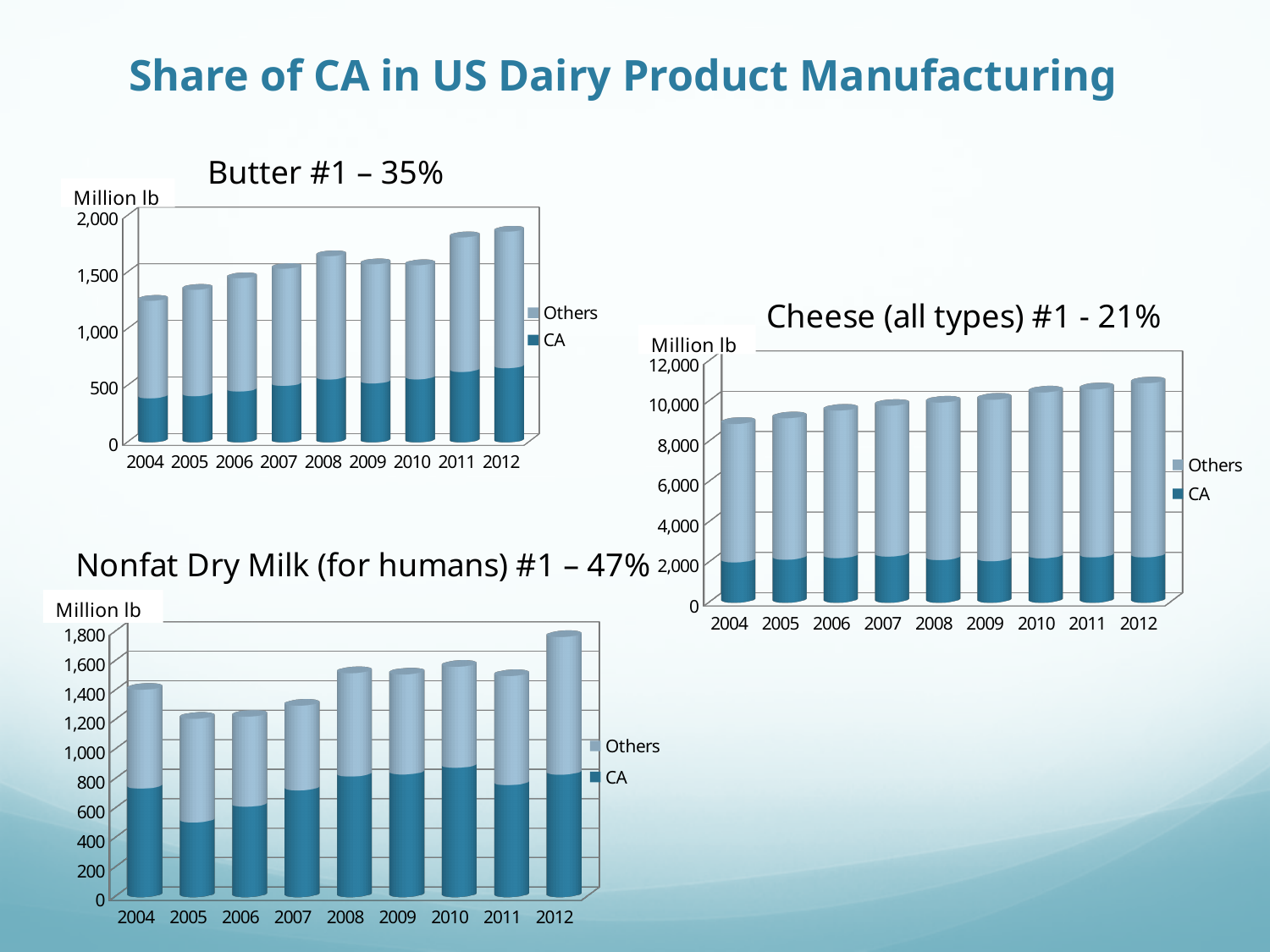
In the Butter #1 – 35% chart, is the total for 2012 greater or less than 1,500? greater In the Cheese (all types) #1 - 21% chart, is the total for 2012 greater or less than 10,000? greater How many years are shown on the x axis of the Cheese (all types) #1 - 21% chart? 9 What kind of chart is the Butter #1 – 35% chart? stacked bar chart In the Nonfat Dry Milk (for humans) #1 – 47% chart, is the total for 2005 greater or less than 1,400? less In the Cheese (all types) #1 - 21% chart, which year has the lowest total bar? 2004 In the Nonfat Dry Milk (for humans) #1 – 47% chart, which year has the highest total bar? 2012 In the Butter #1 – 35% chart, which year has the lowest total bar? 2004 What unit is shown on the y axis of the Butter #1 – 35% chart? Million lb How many series does the legend of the Nonfat Dry Milk (for humans) #1 – 47% chart list? 2 In the Cheese (all types) #1 - 21% chart, do the total bars generally rise or fall from 2004 to 2012? rise